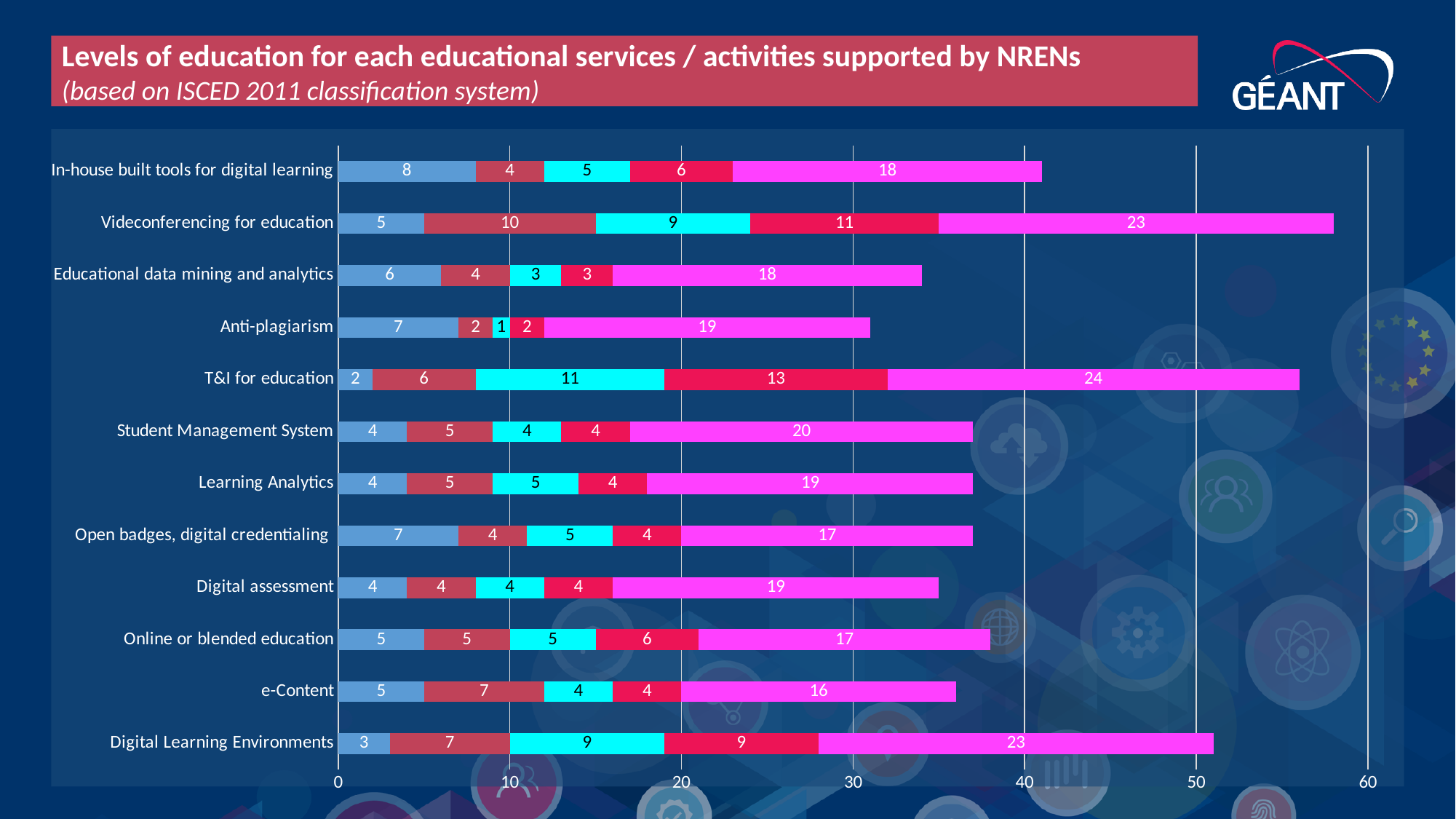
Is the total bar length for Digital Learning Environments greater or less than 50? greater Which has the larger cyan segment: T&I for education or Videoconferencing for education? T&I for education What is the value of the magenta (rightmost) segment for T&I for education? 24 What classification system does the chart title say the levels of education are based on? ISCED 2011 classification system What is the difference between the magenta segment for Videoconferencing for education and the magenta segment for e-Content? 7 What is the value of the blue (leftmost) segment for In-house built tools for digital learning? 8 Which service has the shortest stacked bar overall? Anti-plagiarism What is the total of the stacked bar for Videoconferencing for education? 58 What is the total of the stacked bar for Anti-plagiarism? 31 What kind of chart is shown on the slide? Stacked bar chart How many educational services / activities are listed on the chart? 12 Which service has the longest stacked bar overall? Videoconferencing for education